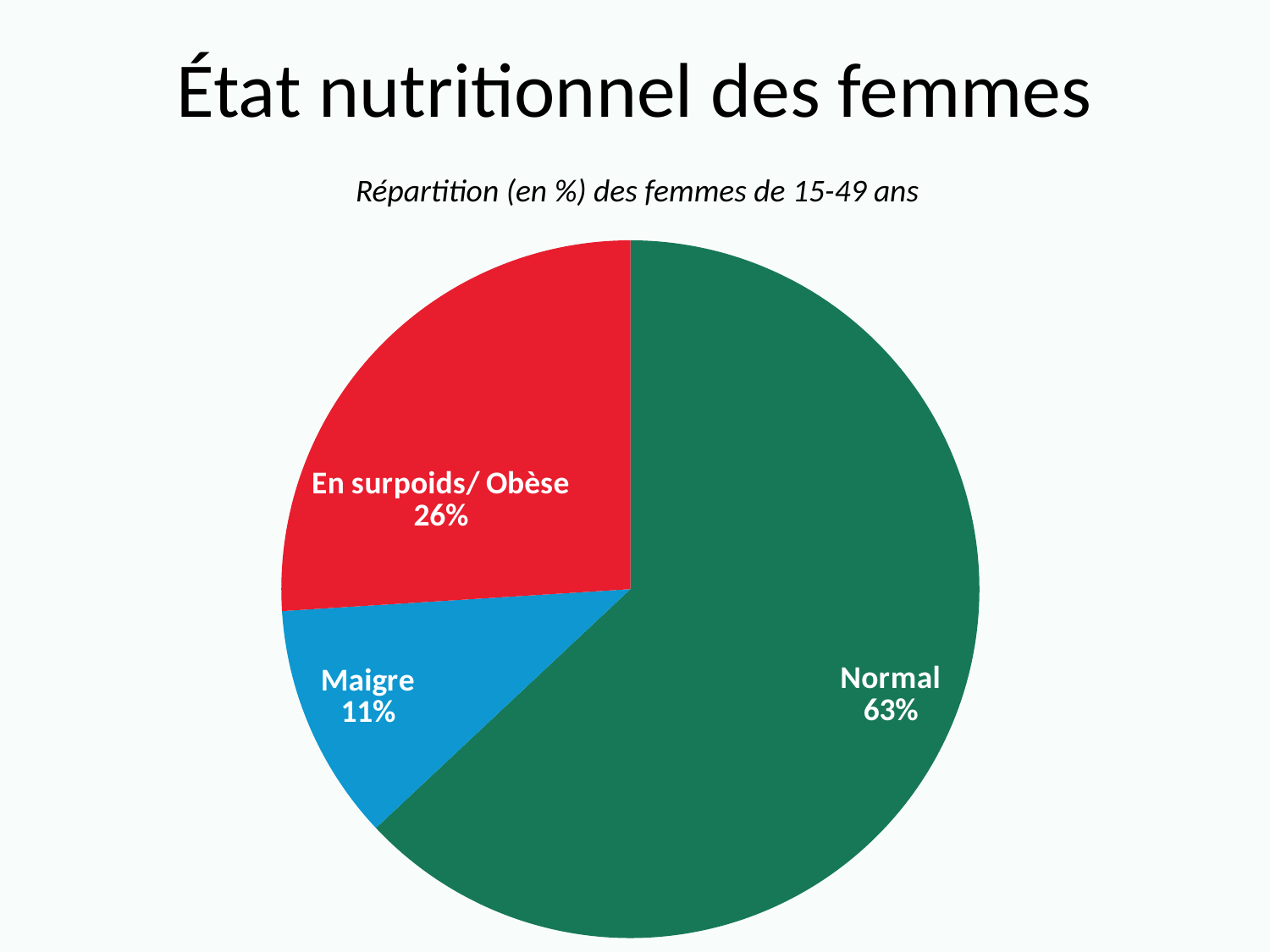
What percentage of women are in the Normal category? 63% Which category has the largest share of the pie? Normal What is the difference in percentage points between the Normal and En surpoids/ Obèse categories? 37 What kind of chart is shown on the slide? Pie chart How many categories does the pie chart show? 3 What colour is the Maigre slice? Blue What percentage of women are in the En surpoids/ Obèse category? 26% What percentage of women are in the Maigre category? 11% What is the difference in percentage points between the En surpoids/ Obèse and Maigre categories? 15 Which category has the smallest share of the pie? Maigre Which is larger, the share for Maigre or the share for En surpoids/ Obèse? En surpoids/ Obèse What is the title of the slide? État nutritionnel des femmes